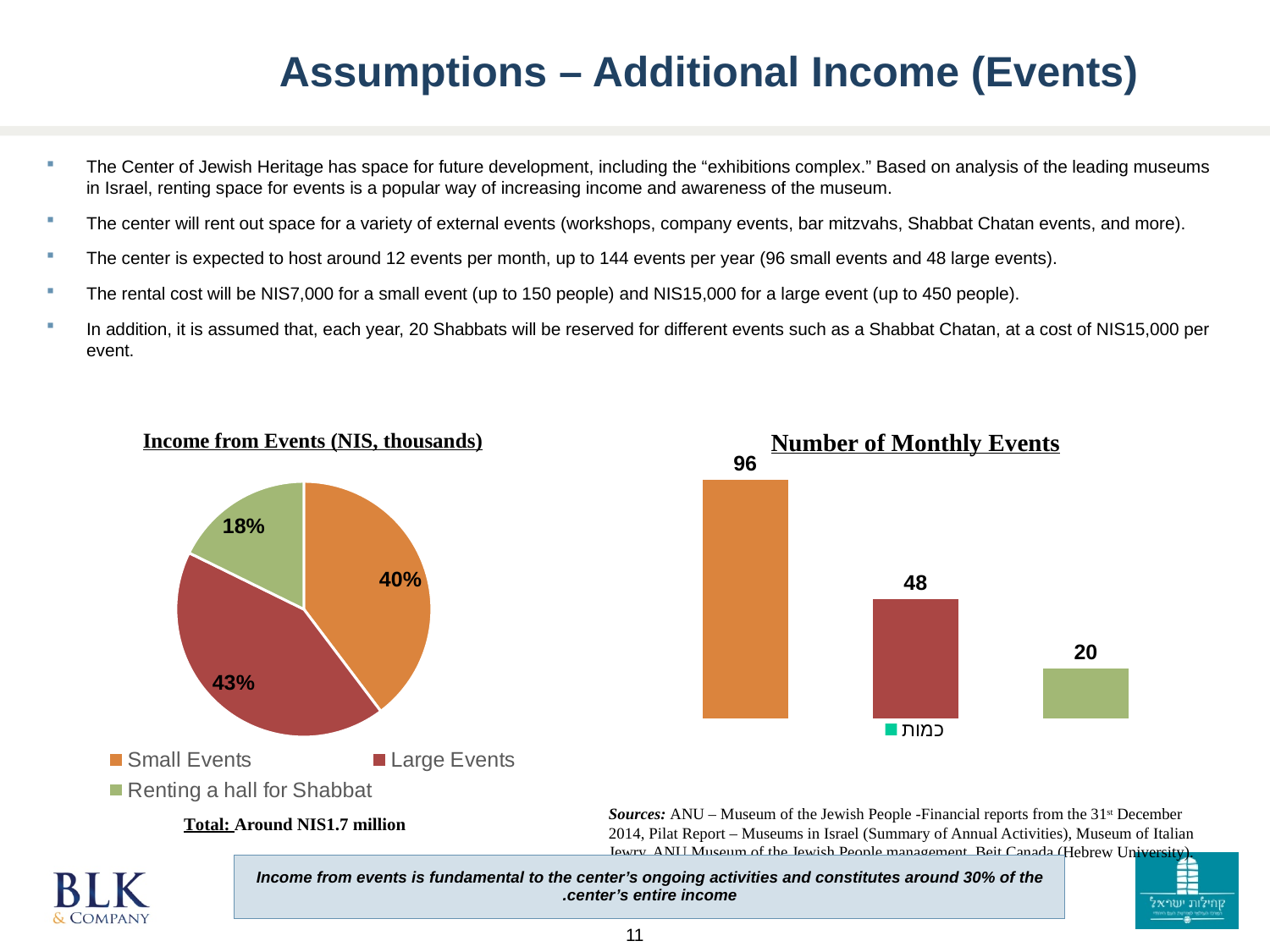
In the 'Number of Monthly Events' chart, how many bars are plotted? 3 In the 'Income from Events (NIS, thousands)' pie chart, what share is Large Events? 43% What type of chart is 'Number of Monthly Events'? Bar chart In the 'Income from Events (NIS, thousands)' pie chart, what share is Renting a hall for Shabbat? 18% In the 'Income from Events (NIS, thousands)' pie chart, how many categories does the legend list? 3 In the 'Number of Monthly Events' chart, what is the value of the third (green) bar? 20 In the 'Income from Events (NIS, thousands)' pie chart, what share is Small Events? 40% In the 'Number of Monthly Events' chart, what is the value of the first (orange) bar? 96 In the 'Income from Events (NIS, thousands)' pie chart, which category has the largest share? Large Events In the 'Income from Events (NIS, thousands)' pie chart, which category has the smallest share? Renting a hall for Shabbat In the 'Number of Monthly Events' chart, what is the difference between the first bar (96) and the second bar (48)? 48 What type of chart is 'Income from Events (NIS, thousands)'? Pie chart